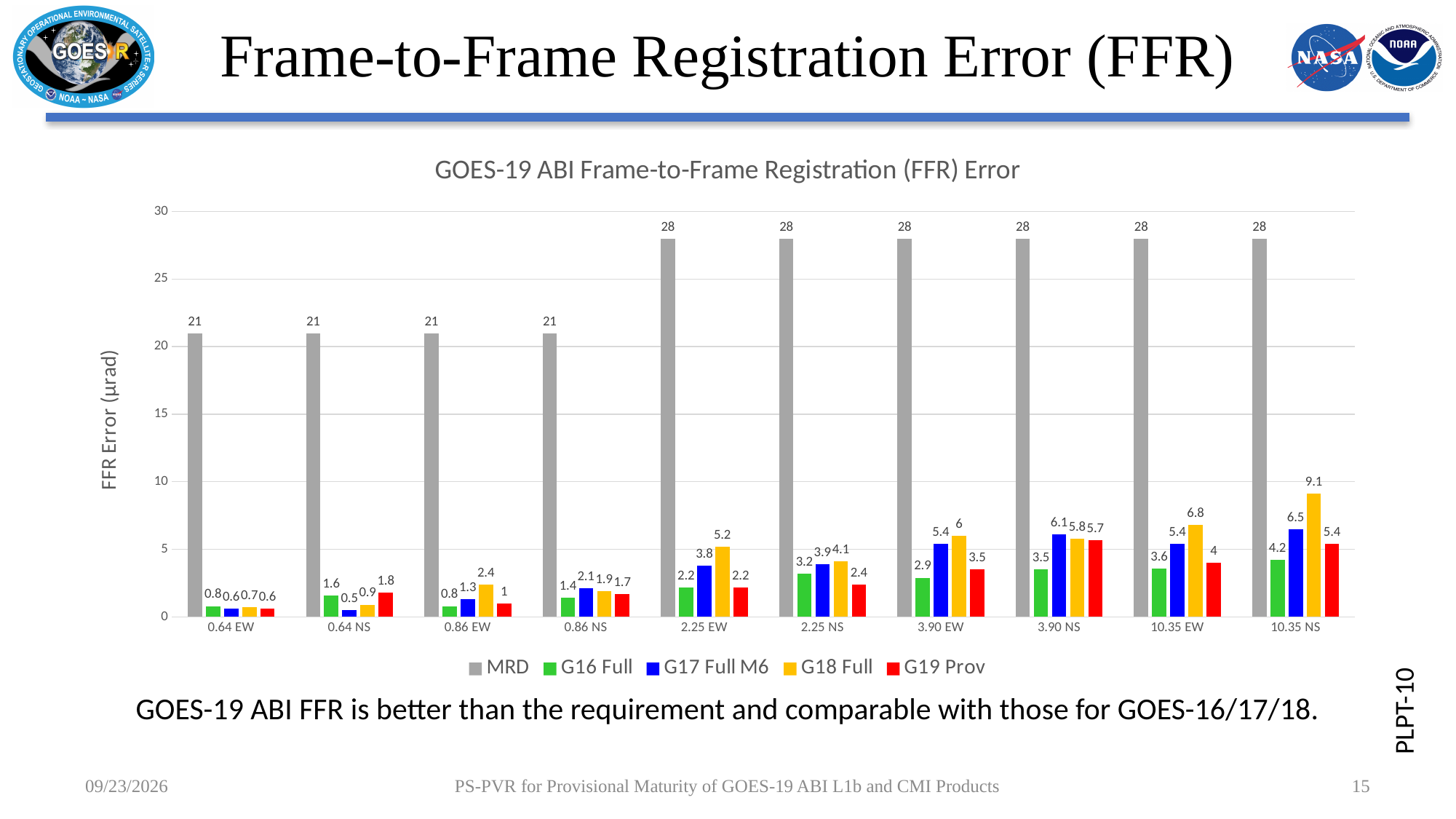
Which category has the highest G18 Full value? 10.35 NS How many categories are shown on the x axis? 10 What is the label of the y axis? FFR Error (μrad) Which is larger for 10.35 EW: the G18 Full value or the G19 Prov value? G18 Full What is the G17 Full M6 value for 3.90 NS? 6.1 What is the difference between the MRD value for 2.25 EW and the MRD value for 0.64 EW? 7 How many series does the legend list? 5 What is the MRD value for 0.86 NS? 21 What is the G19 Prov value for 10.35 NS? 5.4 What is the G18 Full value for 2.25 EW? 5.2 What kind of chart is shown on the slide? Bar chart